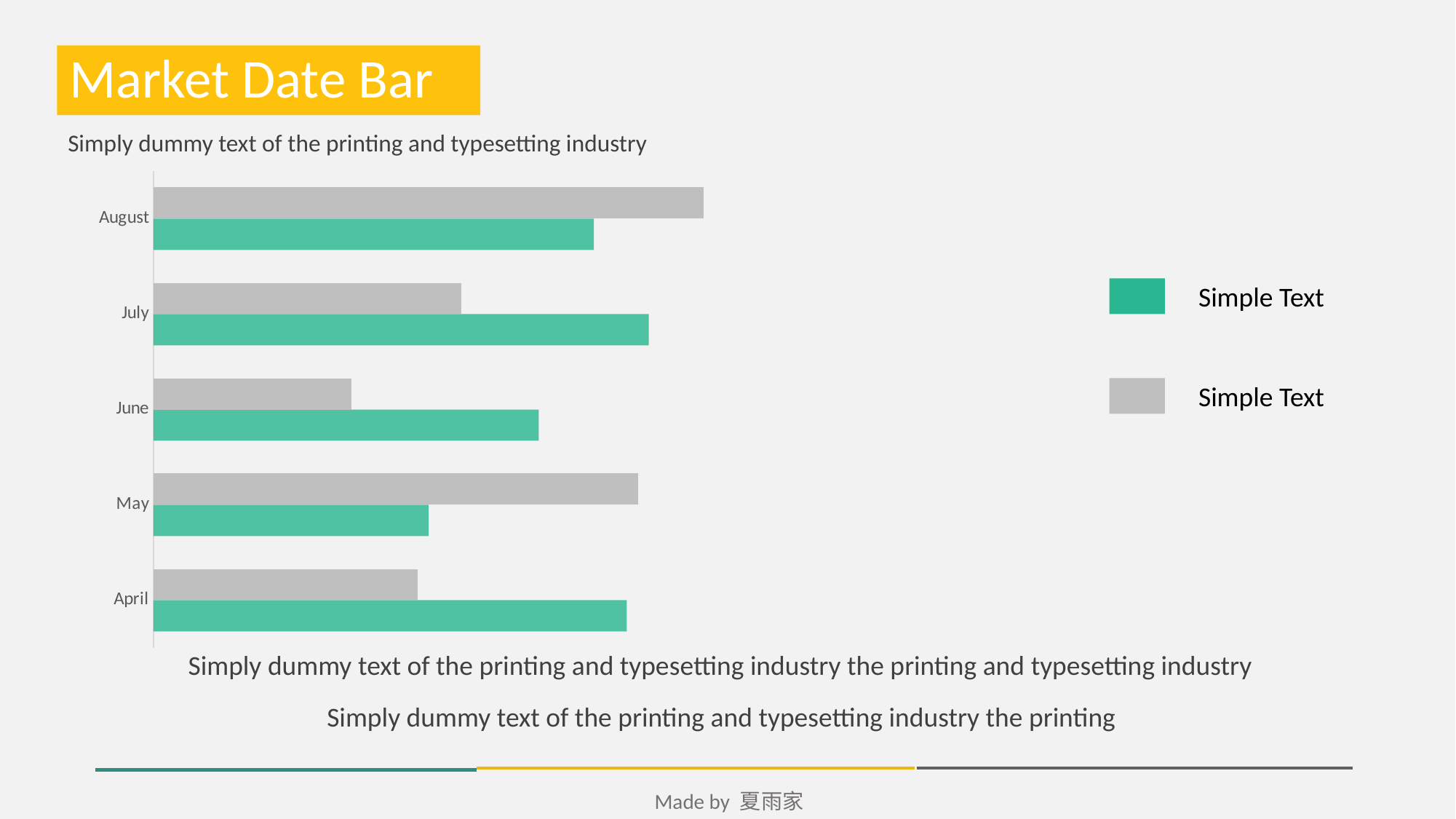
What kind of chart is shown on the slide? bar chart For August, which bar is longer, the gray one or the green one? gray How many months are shown on the chart's vertical axis? 5 Which month has the longer gray bar, August or July? August Which month has the longer green bar, June or May? June Which month has the shortest gray bar? June Which month has the shortest green bar? May What text is used for both entries in the chart's legend? Simple Text How many series does the chart's legend list? 2 Which month has the longest gray bar? August